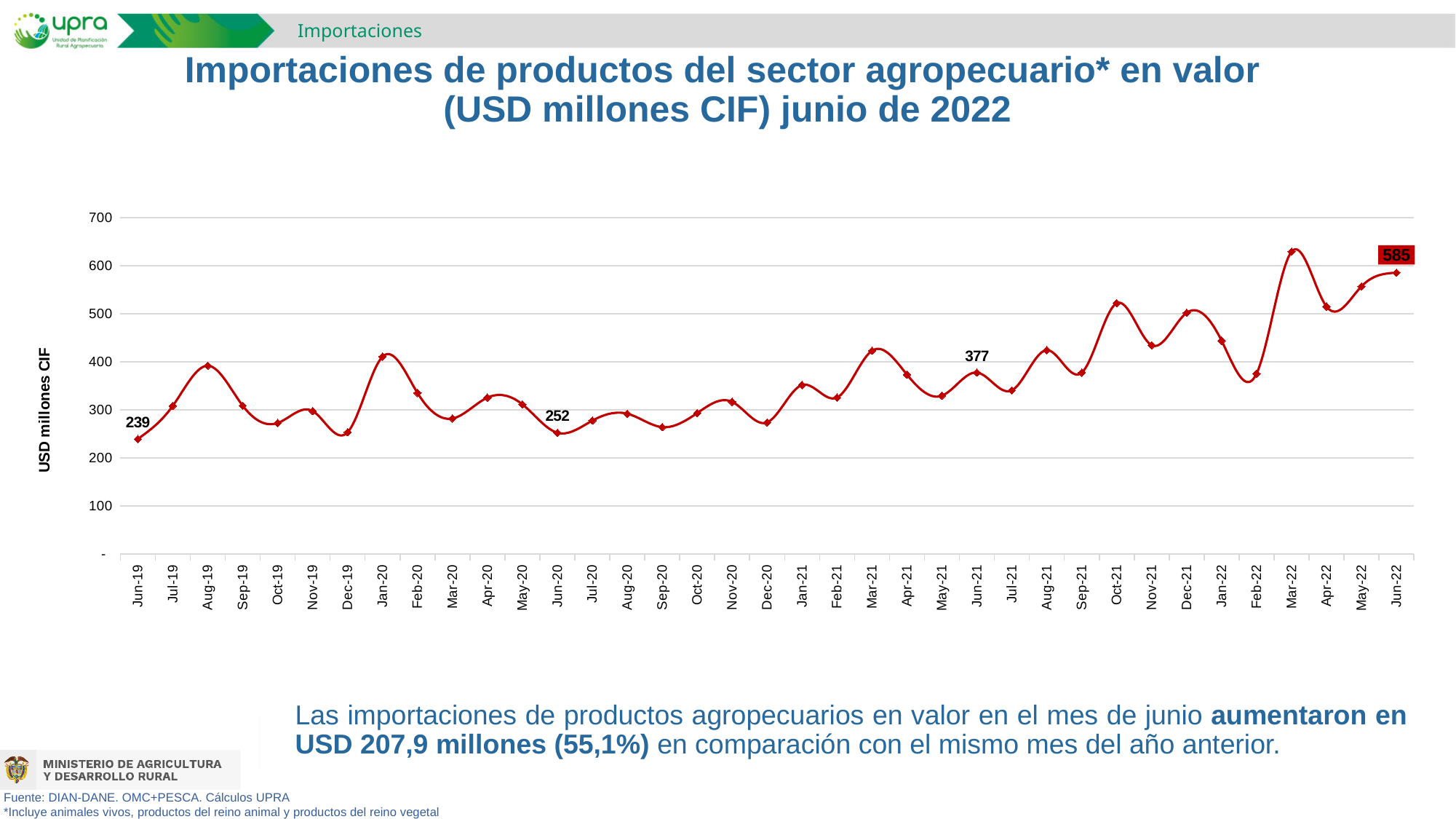
What is the difference between the values for Jun-22 and Jun-21? 208 What is the label of the vertical axis? USD millones CIF What is the value for Jun-20? 252 What is the value for Jun-21? 377 Which month has the highest value on the chart? Mar-22 Is the value for Sep-20 greater or less than 300? less Is the value for Oct-21 greater or less than 500? greater What is the difference between the values for Jun-20 and Jun-19? 13 What is the value for Jun-22? 585 What type of chart is shown on the slide? line chart Which month has the lowest value on the chart? Jun-19 What is the value for Jun-19? 239